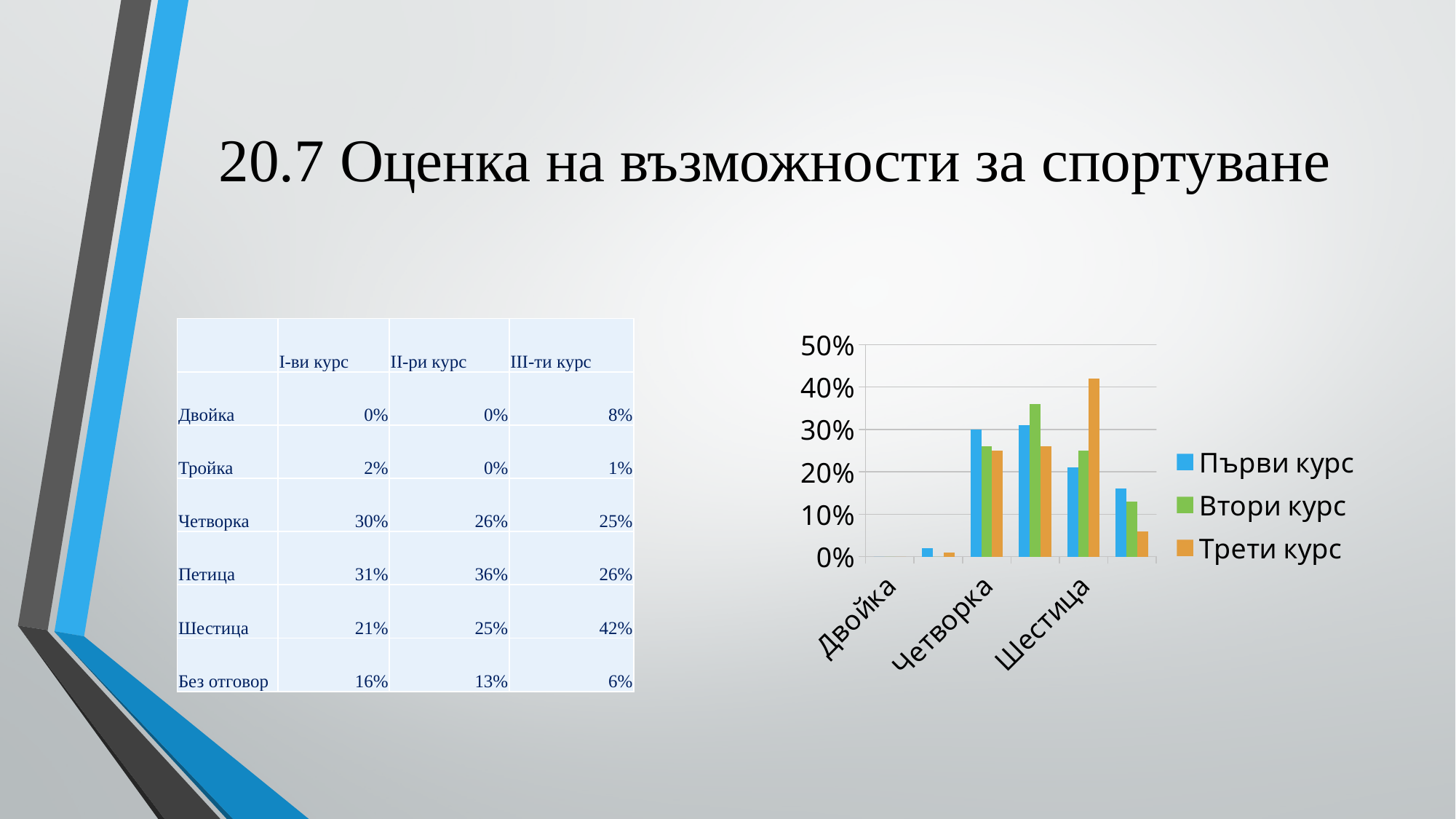
For the category Шестица, which is larger: the value for Трети курс or the value for Първи курс? Трети курс What kind of chart is shown on the slide? bar chart Is the value for Трети курс at Шестица greater or less than 30%? greater How many series does the chart legend list? 3 What are the three series named in the chart legend? Първи курс, Втори курс, Трети курс Is the value for Първи курс at Четворка greater or less than 20%? greater For the category Четворка, which series has the highest bar? Първи курс For the category Шестица, which series has the highest bar? Трети курс Is the value for Трети курс at Четворка greater or less than 20%? greater What is the highest value shown on the chart's vertical axis? 50% For the series Първи курс, which is larger: the value at Четворка or the value at Шестица? Четворка